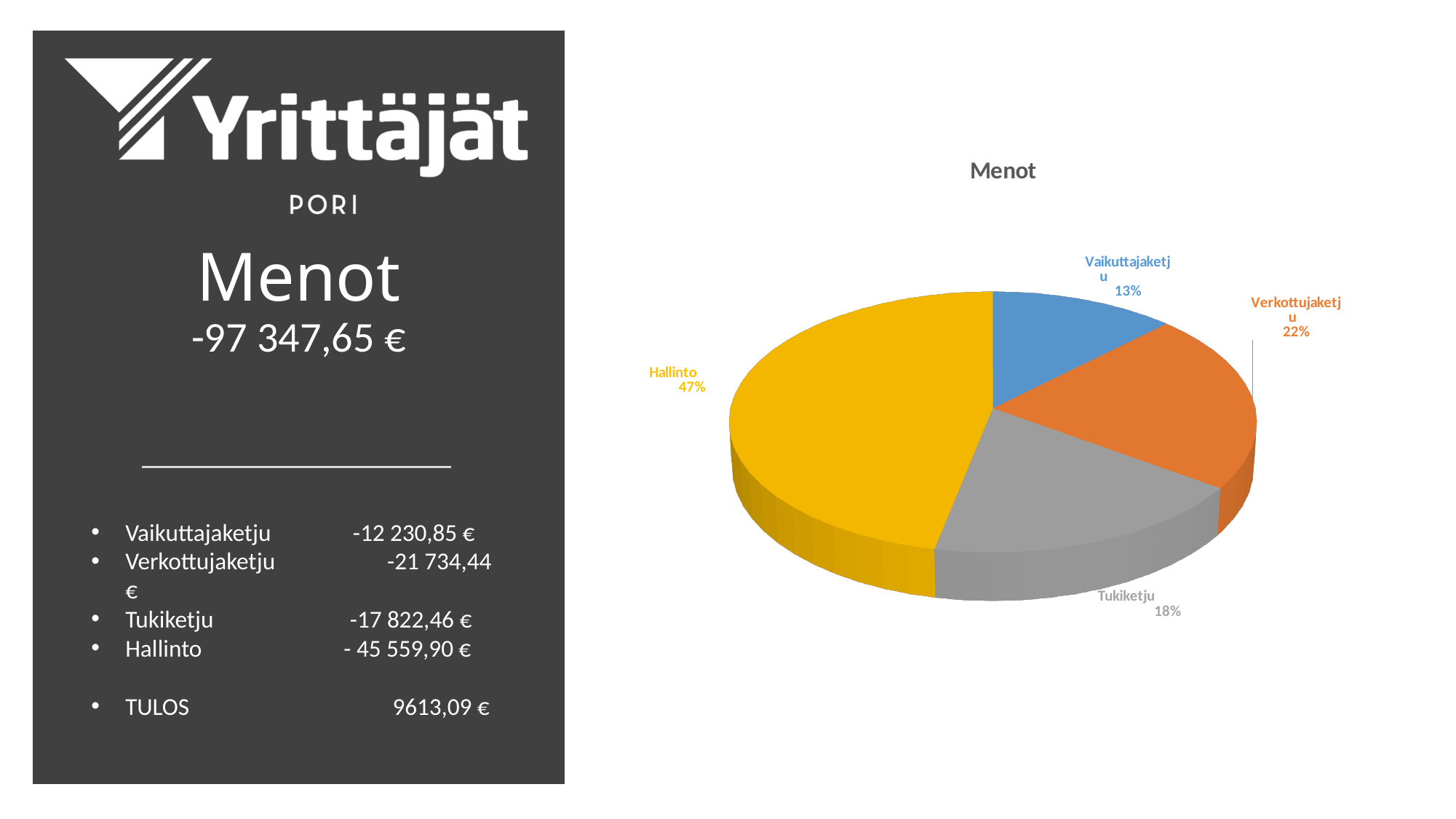
Which slice is larger, Verkottujaketju or Tukiketju? Verkottujaketju What is the title of the pie chart? Menot Which category has the largest slice of the pie? Hallinto What share of the pie does Vaikuttajaketju represent? 13% What colour is the Hallinto slice in the pie chart? yellow What kind of chart is shown on the slide? pie chart What is the difference in percentage points between the Hallinto and Verkottujaketju slices? 25 What share of the pie does Tukiketju represent? 18% What share of the pie does Hallinto represent? 47% Which category has the smallest slice of the pie? Vaikuttajaketju How many slices does the pie chart have? 4